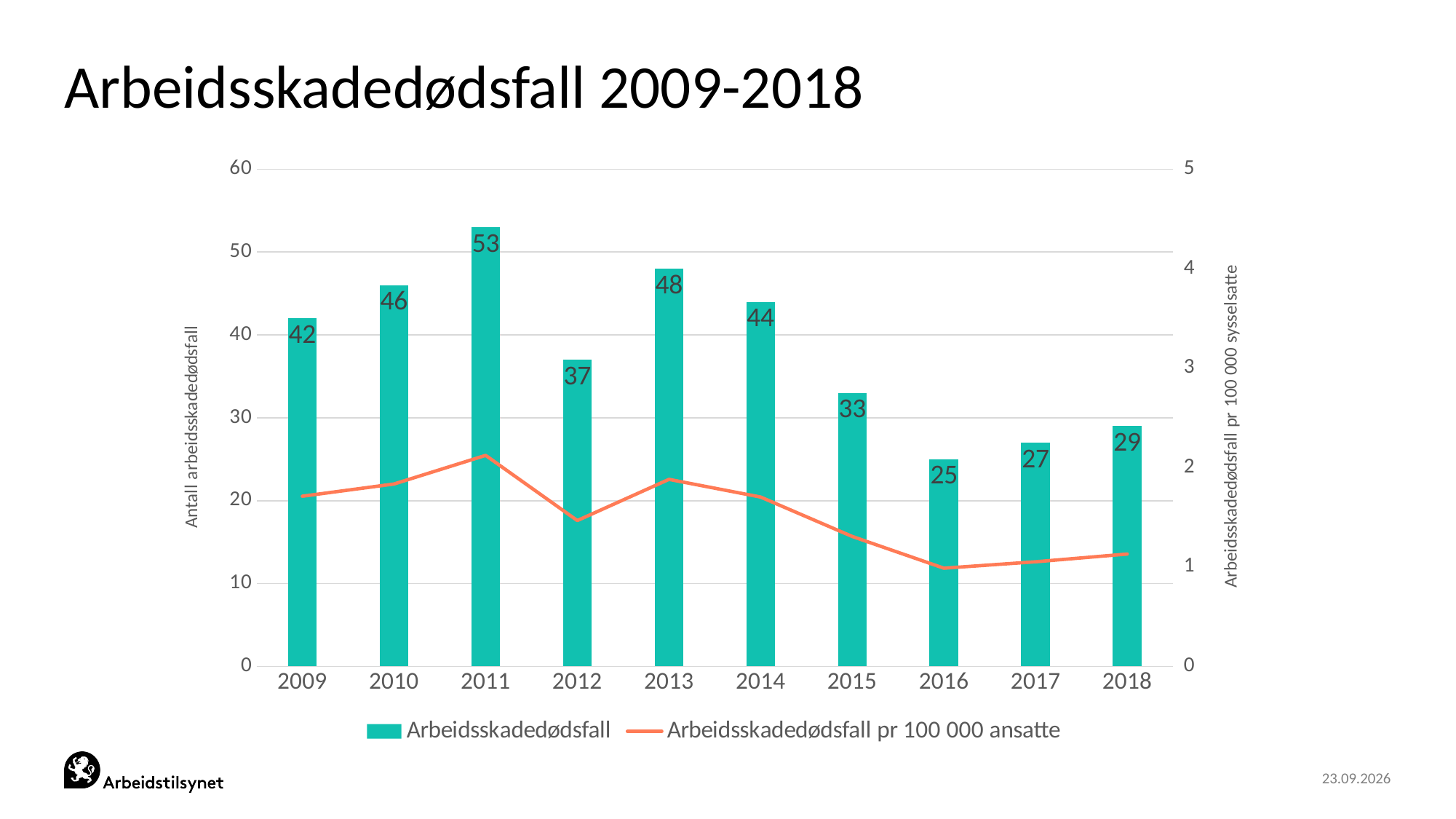
Which year has the highest number of Arbeidsskadedødsfall? 2011 How many years are shown on the x axis? 10 What is the title of the chart? Arbeidsskadedødsfall 2009-2018 What is the value of Arbeidsskadedødsfall for 2011? 53 What is the value of Arbeidsskadedødsfall for 2018? 29 Which year has the lowest number of Arbeidsskadedødsfall? 2016 What is the value of Arbeidsskadedødsfall for 2016? 25 What is the difference in Arbeidsskadedødsfall between 2011 and 2012? 16 Which year has more Arbeidsskadedødsfall, 2013 or 2014? 2013 Is the Arbeidsskadedødsfall pr 100 000 ansatte value for 2011 greater or less than 2? greater How many series does the legend list? 2